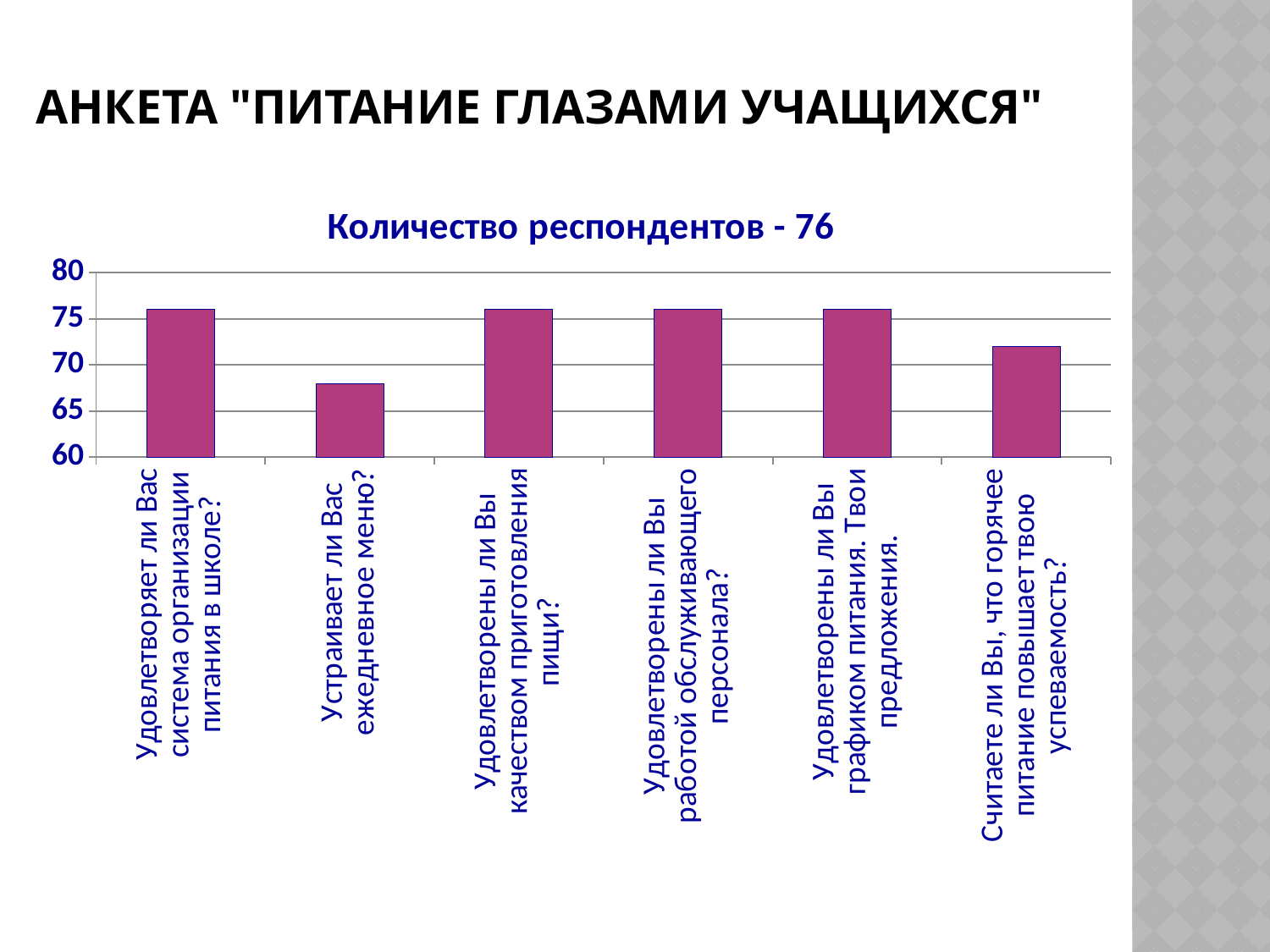
Is the value for "Удовлетворены ли Вы графиком питания. Твои предложения." greater or less than 70? greater Is the value for "Устраивает ли Вас ежедневное меню?" greater or less than 70? less What is the lowest value shown on the vertical axis? 60 Which category has the lowest bar? Устраивает ли Вас ежедневное меню? Is the value for "Удовлетворяет ли Вас система организации питания в школе?" greater or less than 75? greater Which is larger: the value for "Устраивает ли Вас ежедневное меню?" or the value for "Считаете ли Вы, что горячее питание повышает твою успеваемость?"? Считаете ли Вы, что горячее питание повышает твою успеваемость? What is the title of the chart? Количество респондентов - 76 How many categories (questions) are plotted on the chart? 6 Which is larger: the value for "Удовлетворены ли Вы качеством приготовления пищи?" or the value for "Считаете ли Вы, что горячее питание повышает твою успеваемость?"? Удовлетворены ли Вы качеством приготовления пищи? What kind of chart is shown on the slide? bar chart